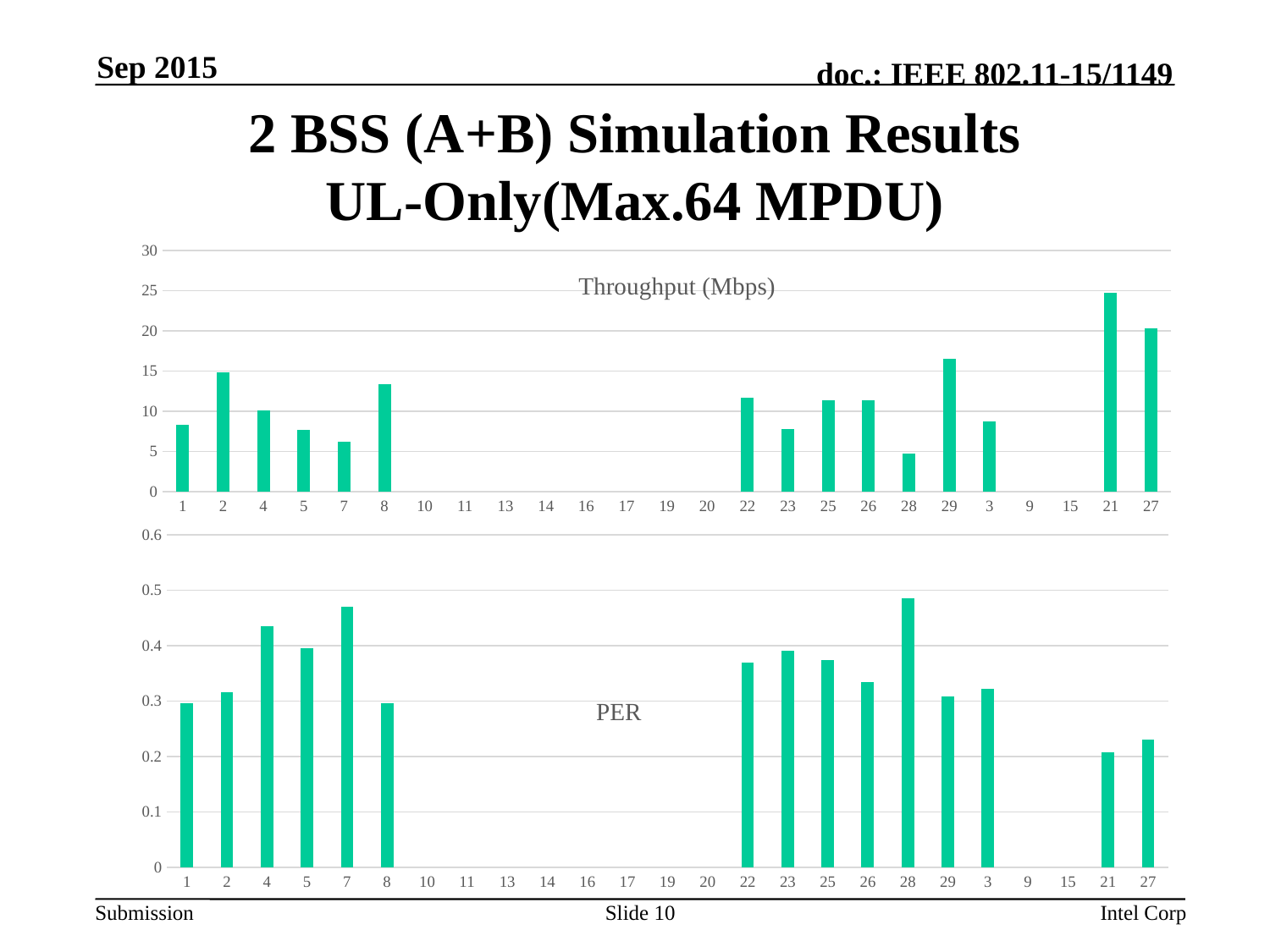
In the PER chart, which is larger, the value for category 7 or category 8? 7 What is the title of the lower chart on the slide? PER In the Throughput (Mbps) chart, is the value for category 29 greater or less than 15? greater What kind of chart is the Throughput (Mbps) chart? bar chart In the PER chart, is the value for category 7 greater or less than 0.4? greater In the Throughput (Mbps) chart, which category has the highest throughput? 21 In the Throughput (Mbps) chart, which is larger, the value for category 21 or category 2? 21 In the PER chart, is the value for category 4 greater or less than 0.4? greater How many categories are shown on the x axis of the Throughput (Mbps) chart? 25